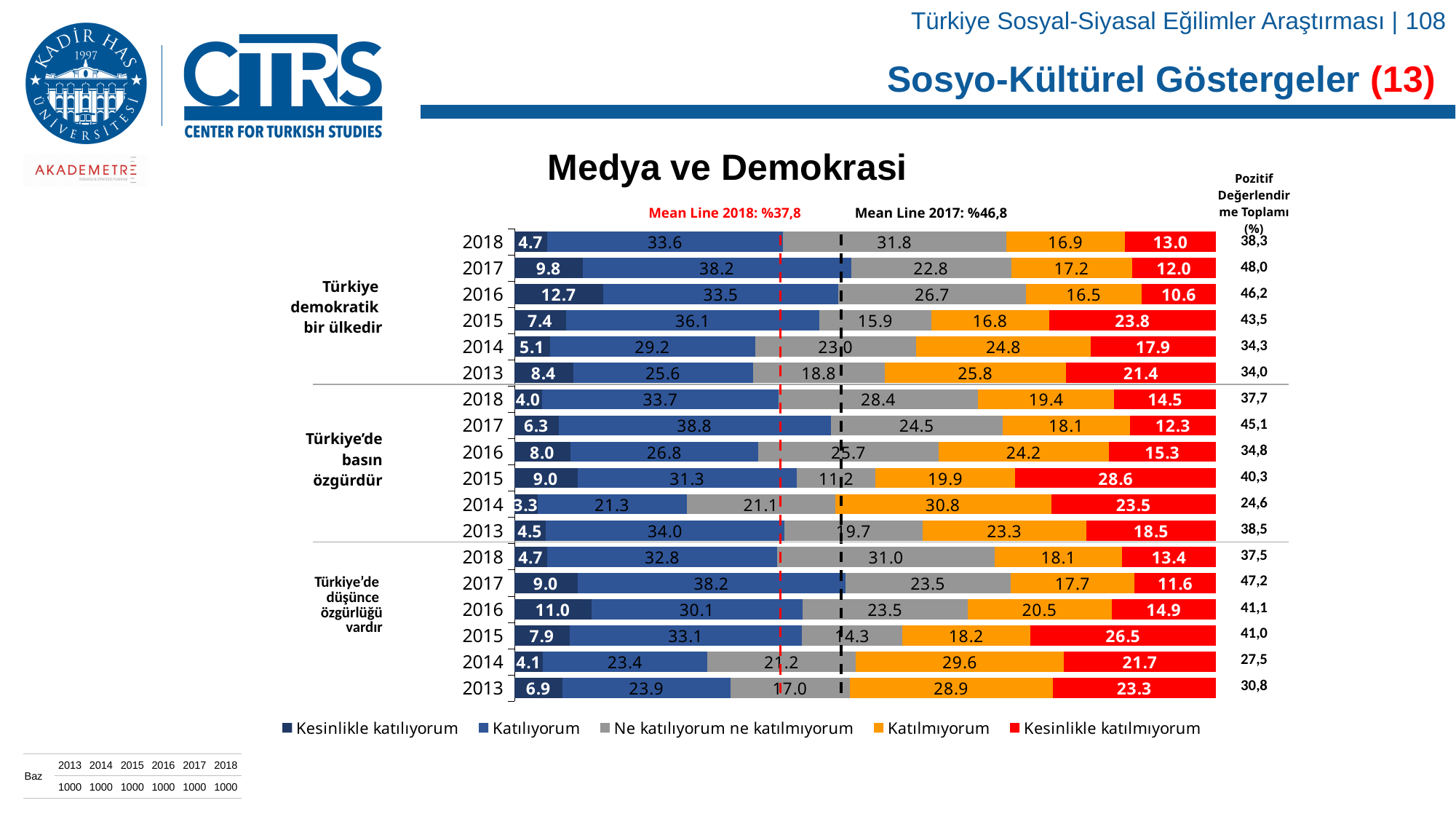
What is the 'Pozitif Değerlendirme Toplamı (%)' shown for 'Türkiye demokratik bir ülkedir' in 2017? 48,0 How many bars are plotted in the chart in total? 18 What is the 'Katılıyorum' value for 'Türkiye demokratik bir ülkedir' in 2018? 33.6 What is the 'Ne katılıyorum ne katılmıyorum' value for 'Türkiye'de düşünce özgürlüğü vardır' in 2014? 21.2 What is the difference between the 'Katılmıyorum' values for 'Türkiye'de basın özgürdür' in 2014 and 2018? 11.4 For 'Türkiye'de düşünce özgürlüğü vardır' in 2017, which is larger: 'Katılıyorum' or 'Ne katılıyorum ne katılmıyorum'? Katılıyorum Which year has the highest 'Kesinlikle katılıyorum' value for 'Türkiye demokratik bir ülkedir'? 2016 Which year has the lowest 'Kesinlikle katılıyorum' value for 'Türkiye'de basın özgürdür'? 2014 What value is given for the Mean Line 2018? %37,8 What is the 'Kesinlikle katılmıyorum' value for 'Türkiye'de basın özgürdür' in 2015? 28.6 How many series does the legend list? 5 What type of chart is shown on the slide? Stacked bar chart